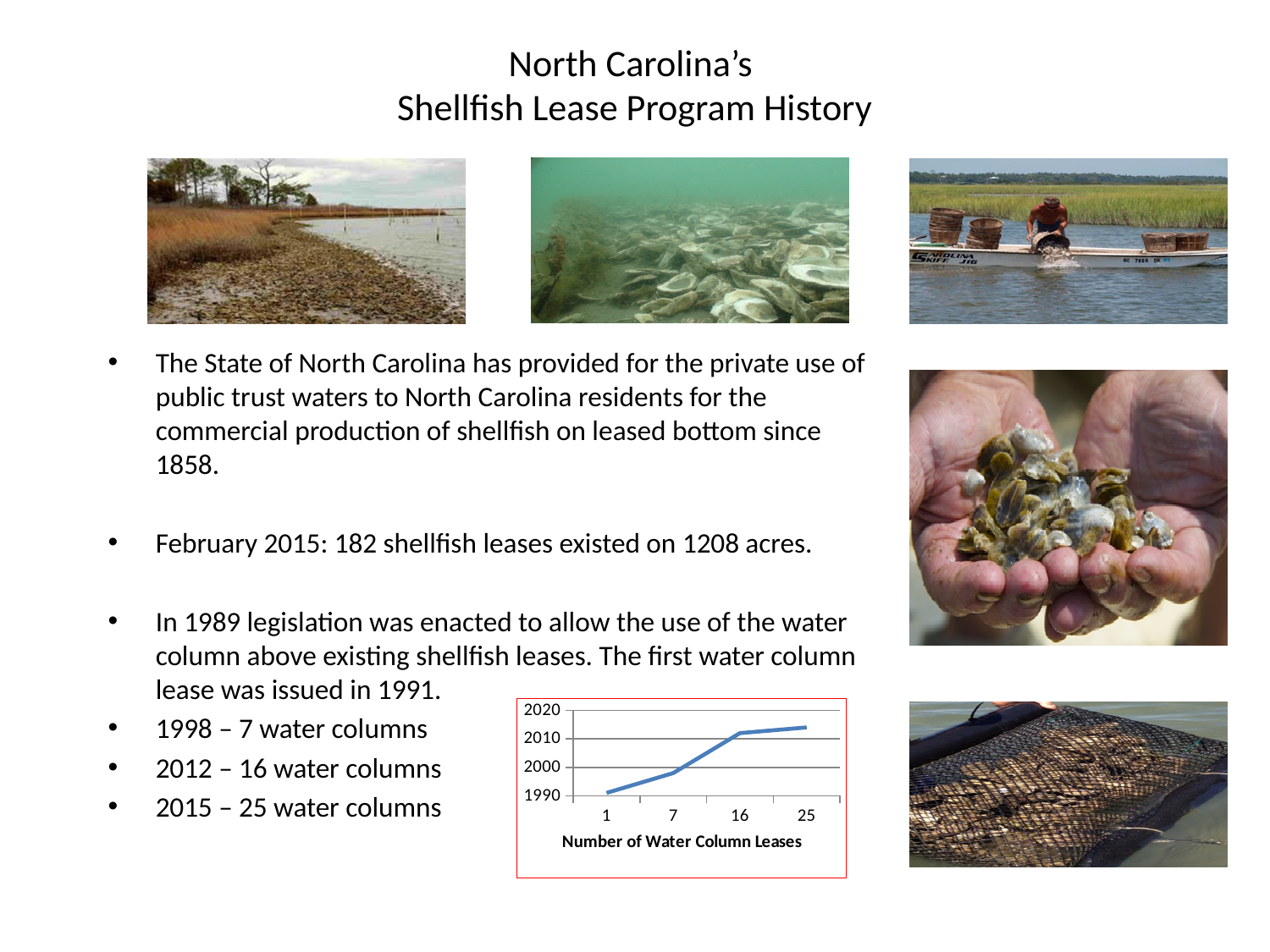
Which x-axis category on the line chart has the highest value? 25 Is the value for 7 on the line chart greater or less than 2010? less Do the values on the line chart rise or fall as the number of water column leases increases along the x axis? rise Is the value for 1 on the line chart greater or less than 2000? less How many data points are plotted on the line chart? 4 What is the x-axis title of the line chart? Number of Water Column Leases Is the value for 25 on the line chart greater or less than 2020? less On the line chart, which has the larger value: 7 or 16? 16 What kind of chart is shown on the slide? line chart Which x-axis category on the line chart has the lowest value? 1